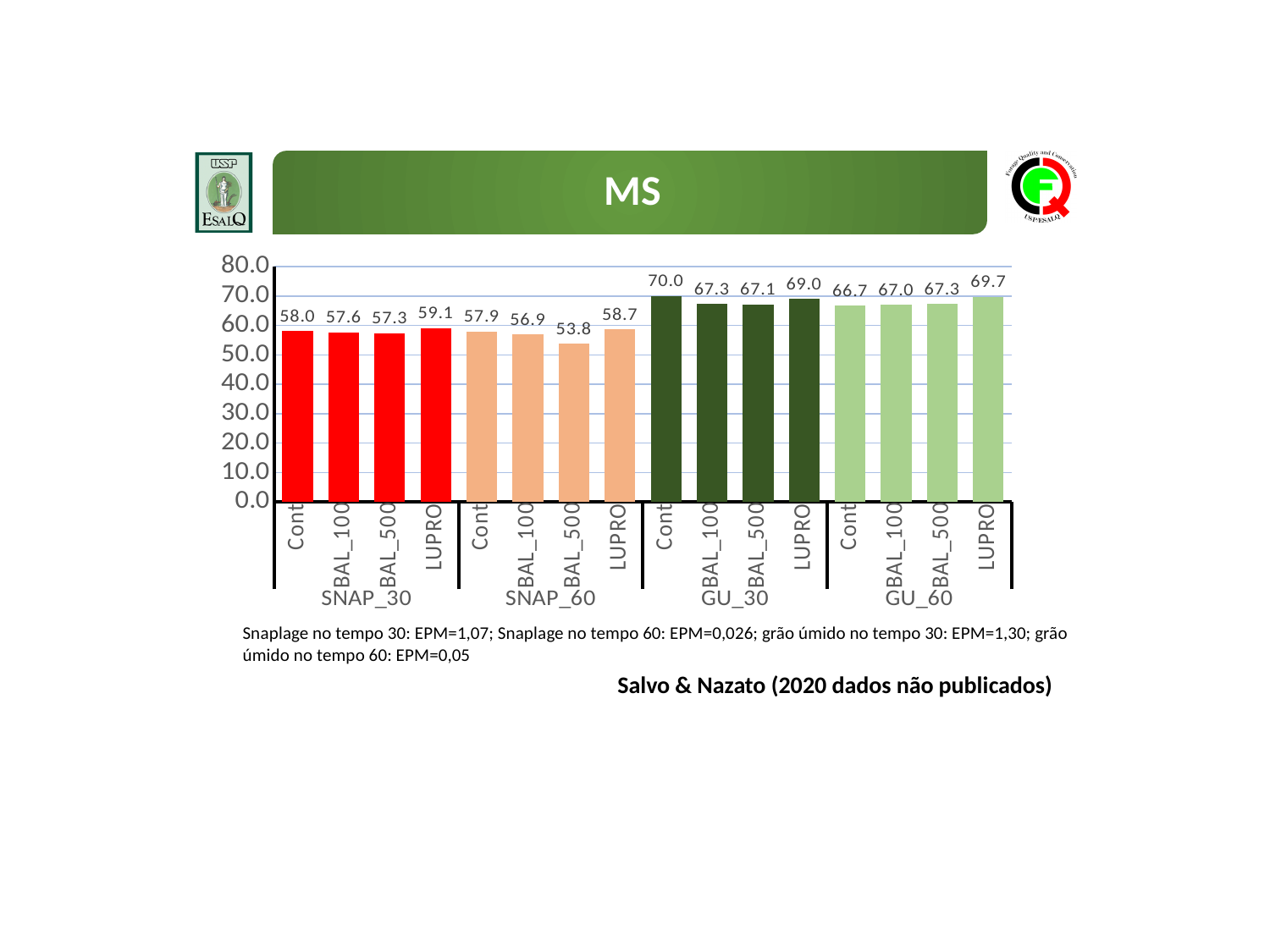
What is the value for BAL_500 in the SNAP_60 group? 53.8 Which is larger: LUPRO in SNAP_30 or LUPRO in SNAP_60? LUPRO in SNAP_30 What type of chart is shown on the slide? Bar chart How many bars are plotted on the chart? 16 What is the title of the chart? MS What is the value for BAL_100 in the GU_30 group? 67.3 Is the value for BAL_500 in SNAP_60 greater or less than 60.0? less What is the value for LUPRO in the GU_60 group? 69.7 What is the difference between the Cont value in GU_30 and the Cont value in SNAP_30? 12.0 Which bar has the lowest value on the chart? BAL_500 in SNAP_60 (53.8) What is the value for Cont in the SNAP_30 group? 58.0 Which bar has the highest value on the chart? Cont in GU_30 (70.0)